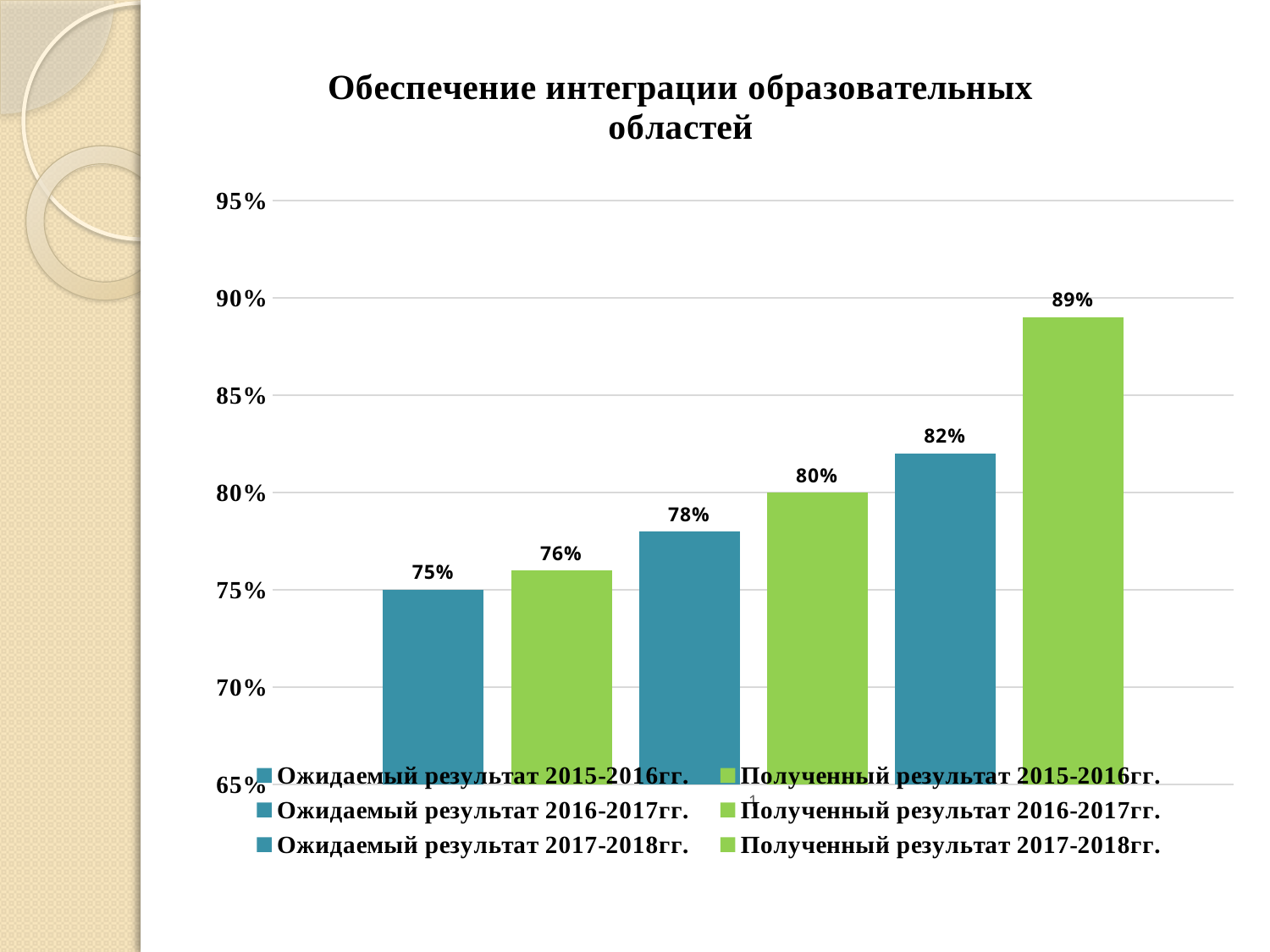
How many bars are plotted on the chart? 6 Is the value for Ожидаемый результат 2017-2018гг. greater or less than 80%? greater How many series does the legend list? 6 What is the title of the chart? Обеспечение интеграции образовательных областей What is the value for Полученный результат 2016-2017гг.? 80% What is the value for Ожидаемый результат 2015-2016гг.? 75% Which series has the lowest value? Ожидаемый результат 2015-2016гг. Which series has the highest value? Полученный результат 2017-2018гг. Which is larger: Ожидаемый результат 2016-2017гг. or Полученный результат 2016-2017гг.? Полученный результат 2016-2017гг. What is the value for Полученный результат 2017-2018гг.? 89% What kind of chart is shown on the slide? bar chart What is the difference between Полученный результат 2017-2018гг. and Ожидаемый результат 2017-2018гг.? 7%